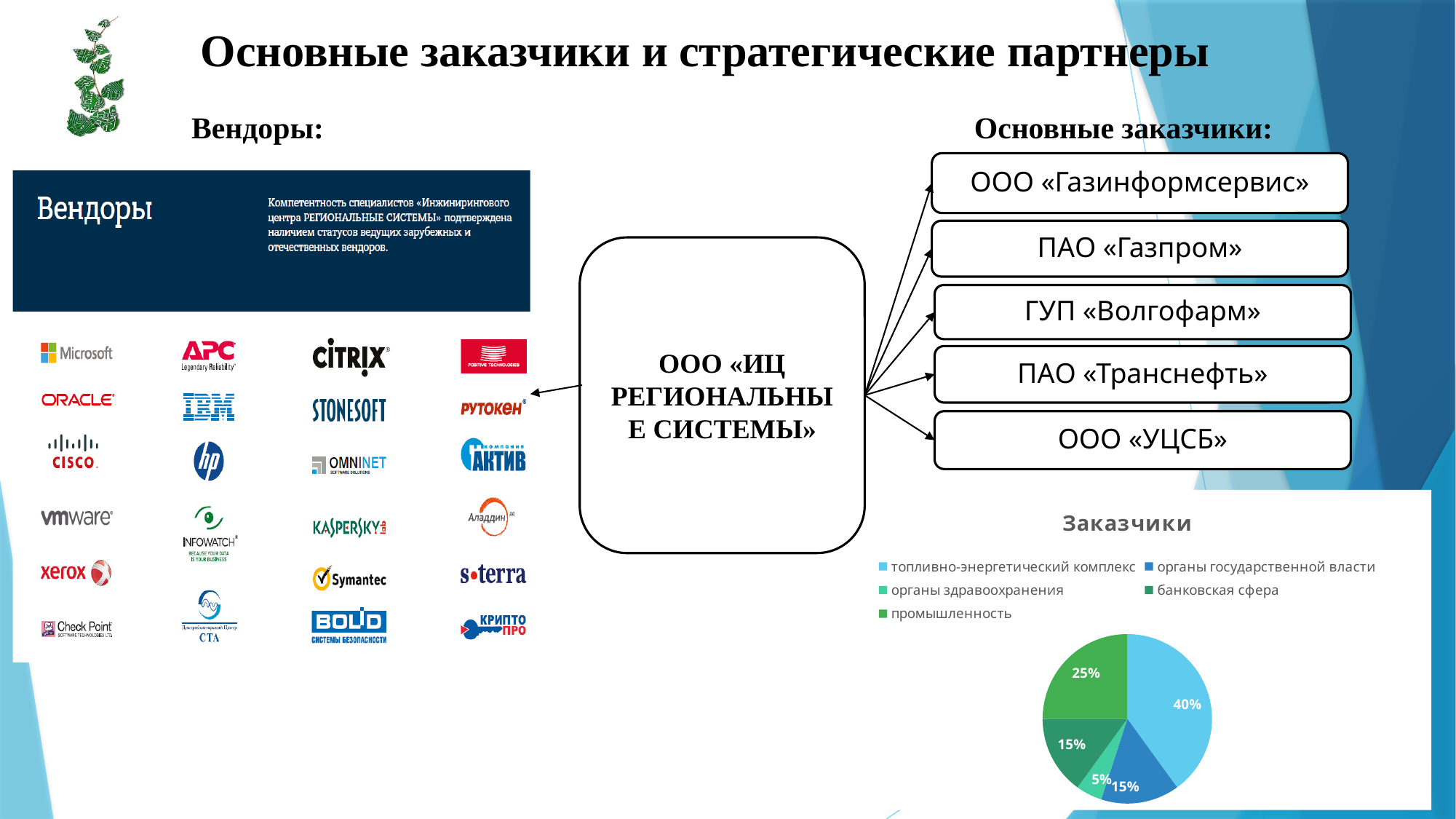
In the «Заказчики» pie chart, what share does «органы государственной власти» have? 15% In the «Заказчики» pie chart, what share does «органы здравоохранения» have? 5% In the «Заказчики» pie chart, what share does «топливно-энергетический комплекс» have? 40% In the «Заказчики» pie chart, which is larger: «промышленность» or «банковская сфера»? промышленность What is the title of the pie chart on the slide? Заказчики How many categories does the legend of the «Заказчики» pie chart list? 5 Which category has the largest slice in the «Заказчики» pie chart? топливно-энергетический комплекс What kind of chart is shown under the title «Заказчики»? pie chart In the «Заказчики» pie chart, how many percentage points larger is «топливно-энергетический комплекс» than «промышленность»? 15% Which category has the smallest slice in the «Заказчики» pie chart? органы здравоохранения